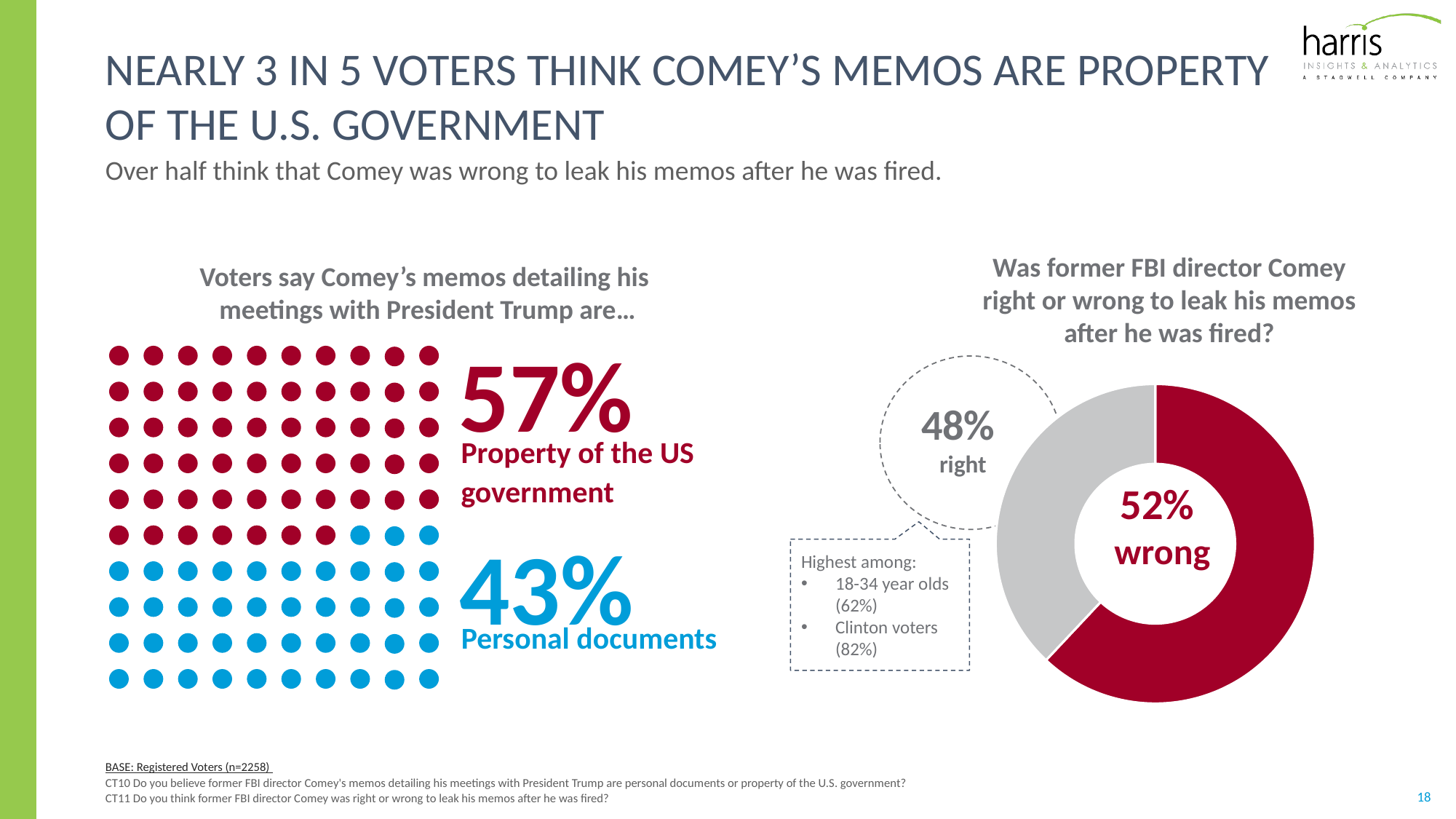
What kind of chart is used for 'Was former FBI director Comey right or wrong to leak his memos after he was fired?' Donut (pie) chart According to the callout on the right chart, what percentage of Clinton voters say Comey was right to leak his memos? 82% In the left chart, which response has the larger share: 'Property of the US government' or 'Personal documents'? Property of the US government In the left chart, what is the difference in percentage points between those saying 'Property of the US government' and those saying 'Personal documents'? 14 percentage points In the left chart, what percentage of voters say Comey's memos are personal documents? 43% In the right chart, what is the difference in percentage points between 'wrong' and 'right'? 4 percentage points In the right chart, which response has the larger slice: 'right' or 'wrong'? wrong In the left chart, which colour represents 'Personal documents'? Blue In the right chart, what percentage of voters say Comey was right to leak his memos? 48% In the left chart, what percentage of voters say Comey's memos are property of the US government? 57% How many slices does the right donut chart have? 2 In the right chart, what percentage of voters say Comey was wrong to leak his memos? 52%